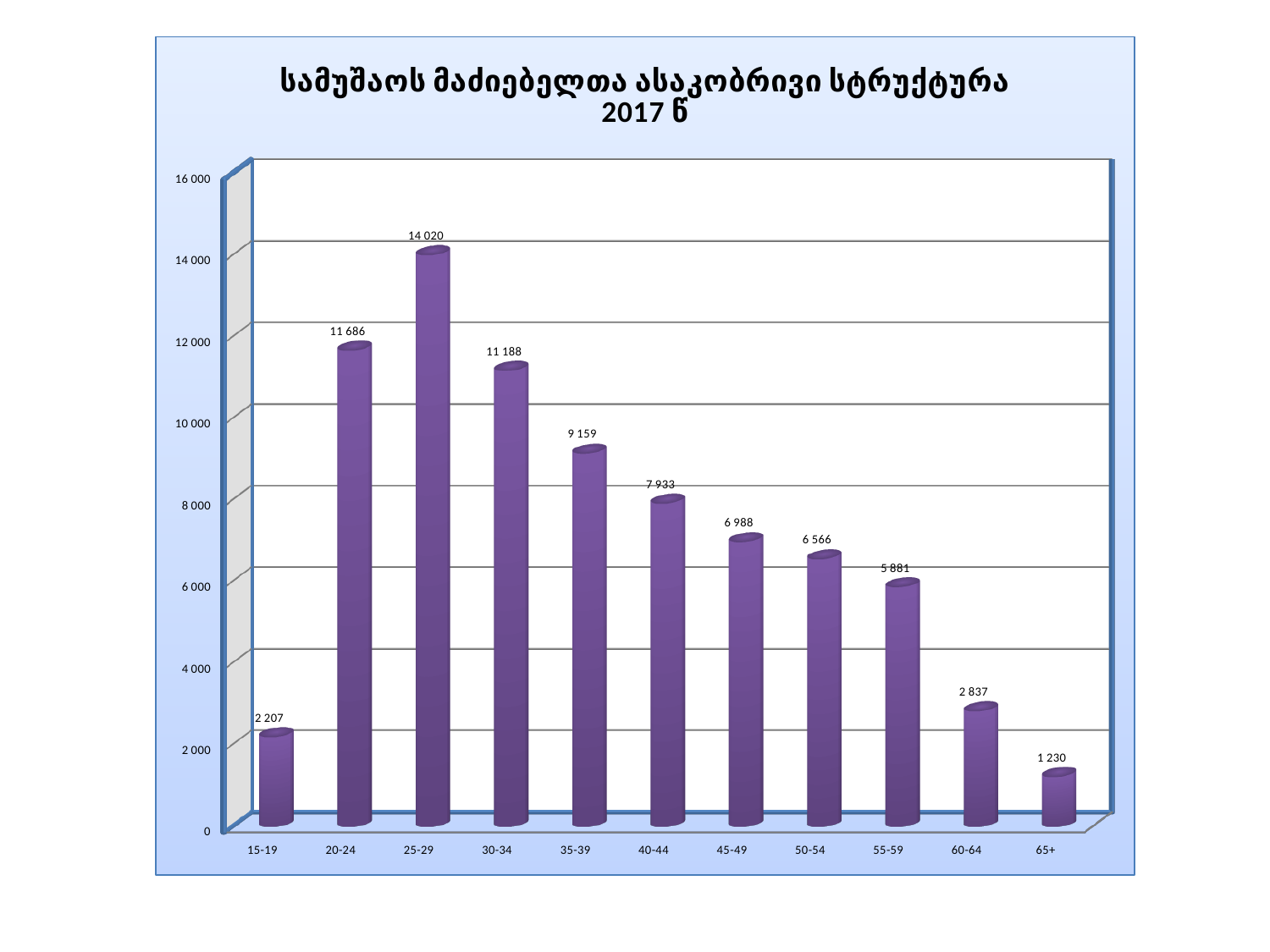
Is the value for 45-49 greater or less than 6 000? greater Which age group has the lowest value? 65+ What is the value for the 65+ age group? 1 230 What is the value for the 25-29 age group? 14 020 What is the value for the 55-59 age group? 5 881 Do the values rise or fall from the 25-29 group to the 65+ group? fall What is the difference between the values for 20-24 and 30-34? 498 What is the difference between the values for 60-64 and 65+? 1 607 What kind of chart is shown on the slide? bar chart Which is larger, the value for 35-39 or the value for 40-44? 35-39 Which age group has the highest value? 25-29 How many age groups are shown on the x axis? 11